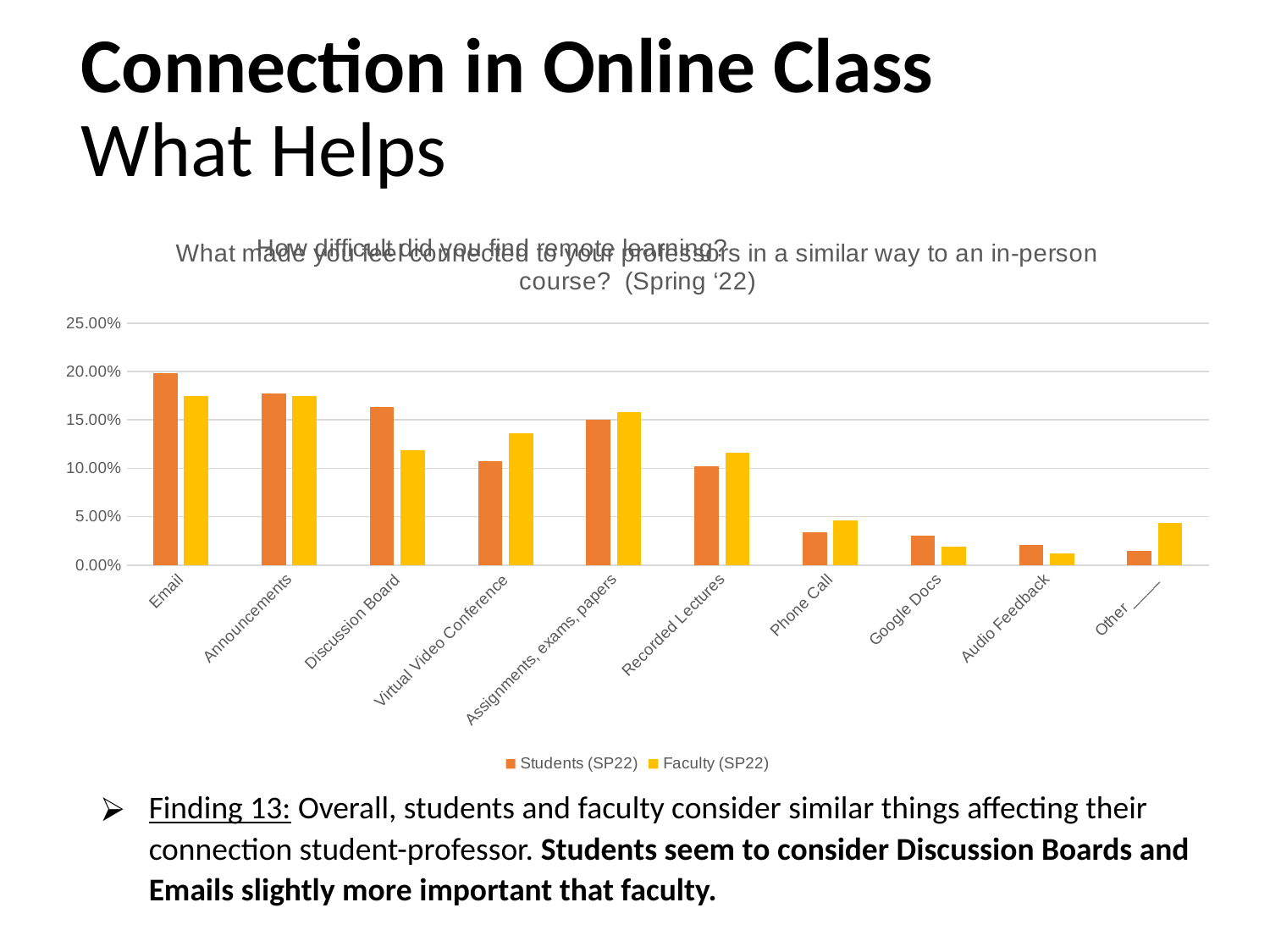
How many series does the chart's legend list? 2 Is the Students (SP22) value for Virtual Video Conference greater or less than 15.00%? less Is the Students (SP22) value for Email greater or less than 15.00%? greater How many categories are shown on the x axis of the chart? 10 For Virtual Video Conference, which series has the larger value, Students (SP22) or Faculty (SP22)? Faculty (SP22) For Other, which series has the larger value, Students (SP22) or Faculty (SP22)? Faculty (SP22) Is the Faculty (SP22) value for Phone Call greater or less than 5.00%? less Which category has the highest value for Students (SP22)? Email What are the two series named in the chart's legend? Students (SP22) and Faculty (SP22) What kind of chart is shown on the slide? bar chart For Discussion Board, which series has the larger value, Students (SP22) or Faculty (SP22)? Students (SP22)